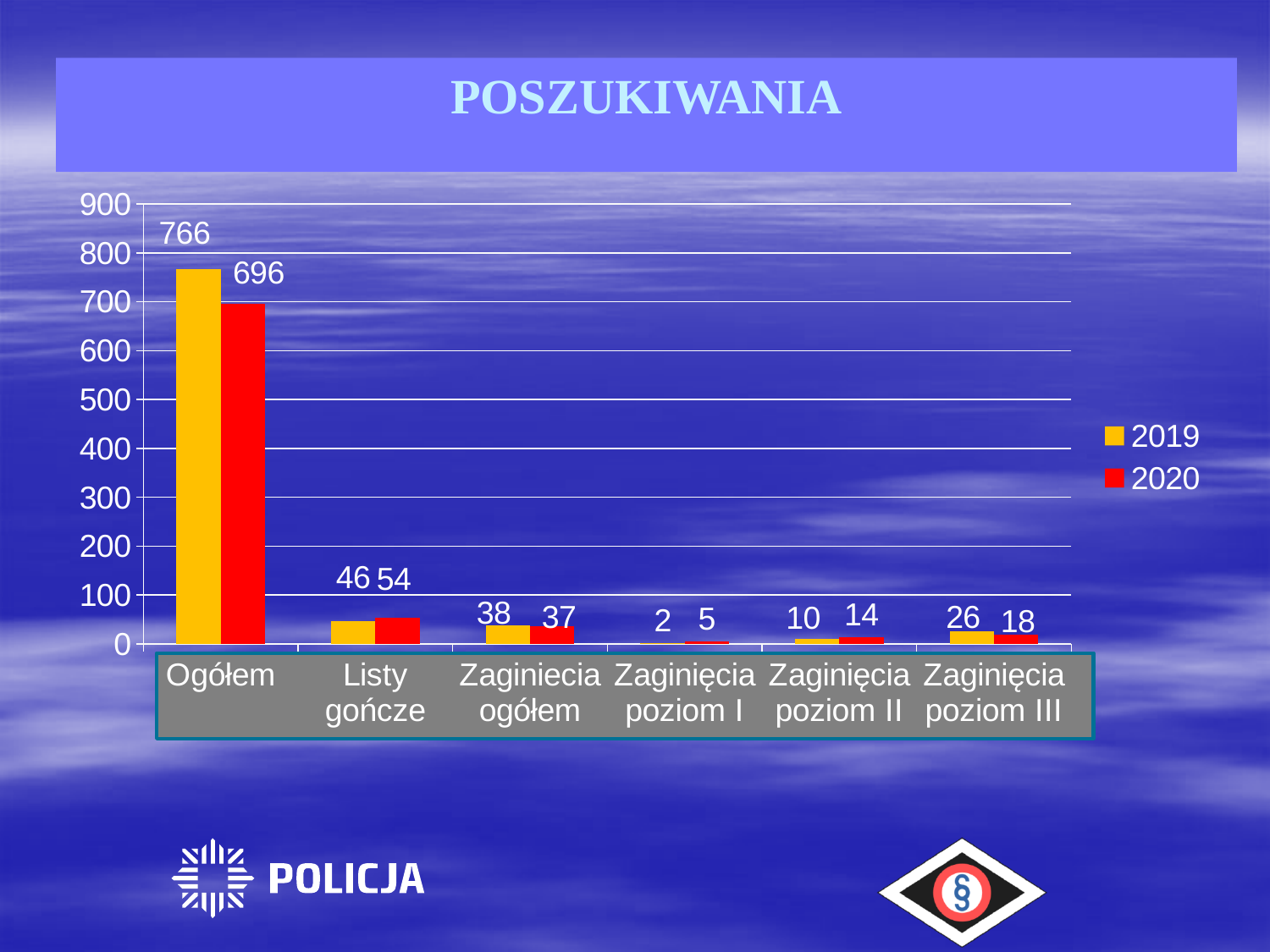
What is the value for Ogółem in 2019? 766 What is the difference between the 2019 and 2020 values for Ogółem? 70 Which category has the lowest value in 2020? Zaginięcia poziom I What kind of chart is shown on the slide? bar chart What is the value for Ogółem in 2020? 696 Which category has the highest value in 2019? Ogółem Is the 2020 value for Ogółem greater or less than 600? greater How many categories are shown on the x axis? 6 What is the value for Zaginięcia poziom II in 2019? 10 How many series does the legend list? 2 Which is larger for Zaginięcia poziom III: the 2019 value or the 2020 value? 2019 What is the value for Listy gończe in 2020? 54